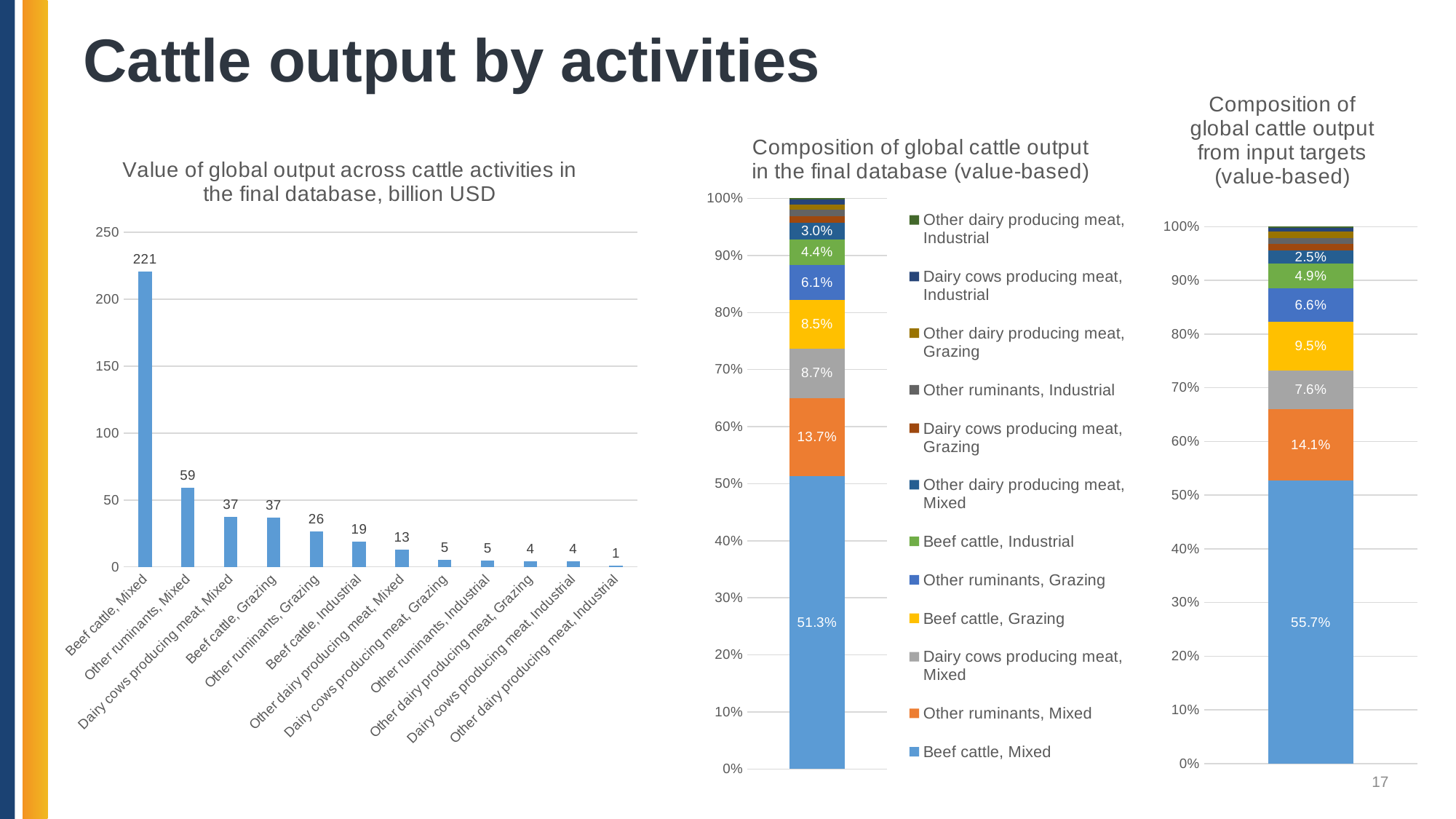
In the chart 'Value of global output across cattle activities in the final database, billion USD', what is the difference between Beef cattle, Mixed and Other ruminants, Mixed? 162 In the chart 'Value of global output across cattle activities in the final database, billion USD', what is the value for Beef cattle, Mixed? 221 In the chart 'Value of global output across cattle activities in the final database, billion USD', which is larger: Beef cattle, Industrial or Other dairy producing meat, Mixed? Beef cattle, Industrial In the chart 'Composition of global cattle output in the final database (value-based)', what share is Other ruminants, Mixed? 13.7% In the chart 'Composition of global cattle output from input targets (value-based)', what share is Beef cattle, Grazing? 9.5% In the chart 'Value of global output across cattle activities in the final database, billion USD', which category has the lowest value? Other dairy producing meat, Industrial How many series does the legend list in the chart 'Composition of global cattle output in the final database (value-based)'? 12 What kind of chart is 'Value of global output across cattle activities in the final database, billion USD'? Bar chart In the chart 'Value of global output across cattle activities in the final database, billion USD', what is the value for Other ruminants, Grazing? 26 In the chart 'Composition of global cattle output from input targets (value-based)', what is the difference between the Beef cattle, Mixed share and the Other ruminants, Mixed share? 41.6% How many categories are shown in the chart 'Value of global output across cattle activities in the final database, billion USD'? 12 In the chart 'Composition of global cattle output in the final database (value-based)', what share is Beef cattle, Mixed? 51.3%